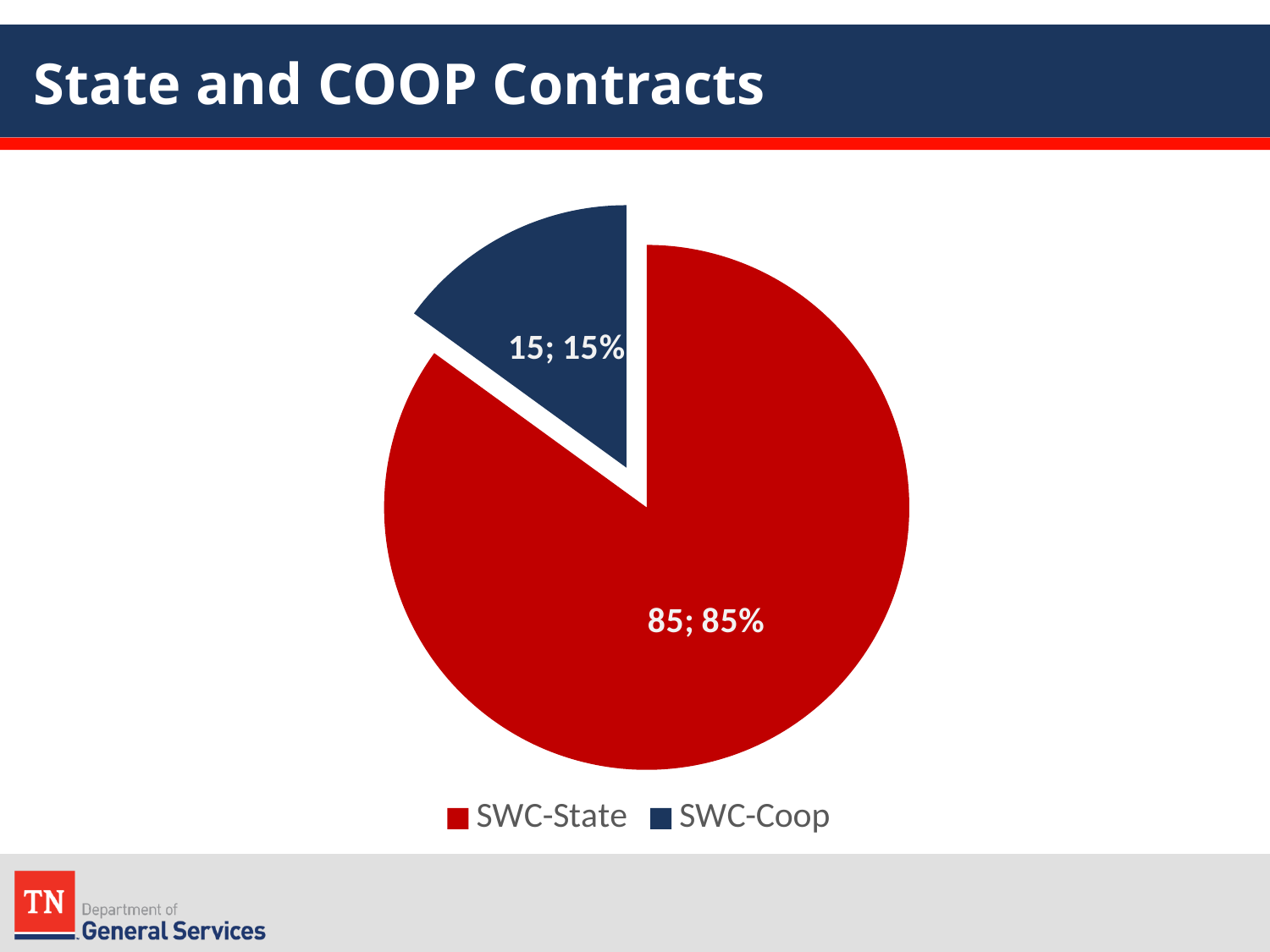
What colour is the SWC-Coop slice? dark blue What share of the pie does SWC-State represent? 85% What kind of chart is shown on the slide? pie chart What is the difference between the values for SWC-State and SWC-Coop? 70 What is the total of the two slice values? 100 What is the value for SWC-State? 85 How many slices does the pie chart have? 2 Which is larger, SWC-State or SWC-Coop? SWC-State What is the value for SWC-Coop? 15 Which category has the largest slice? SWC-State What share of the pie does SWC-Coop represent? 15% Which category has the smallest slice? SWC-Coop